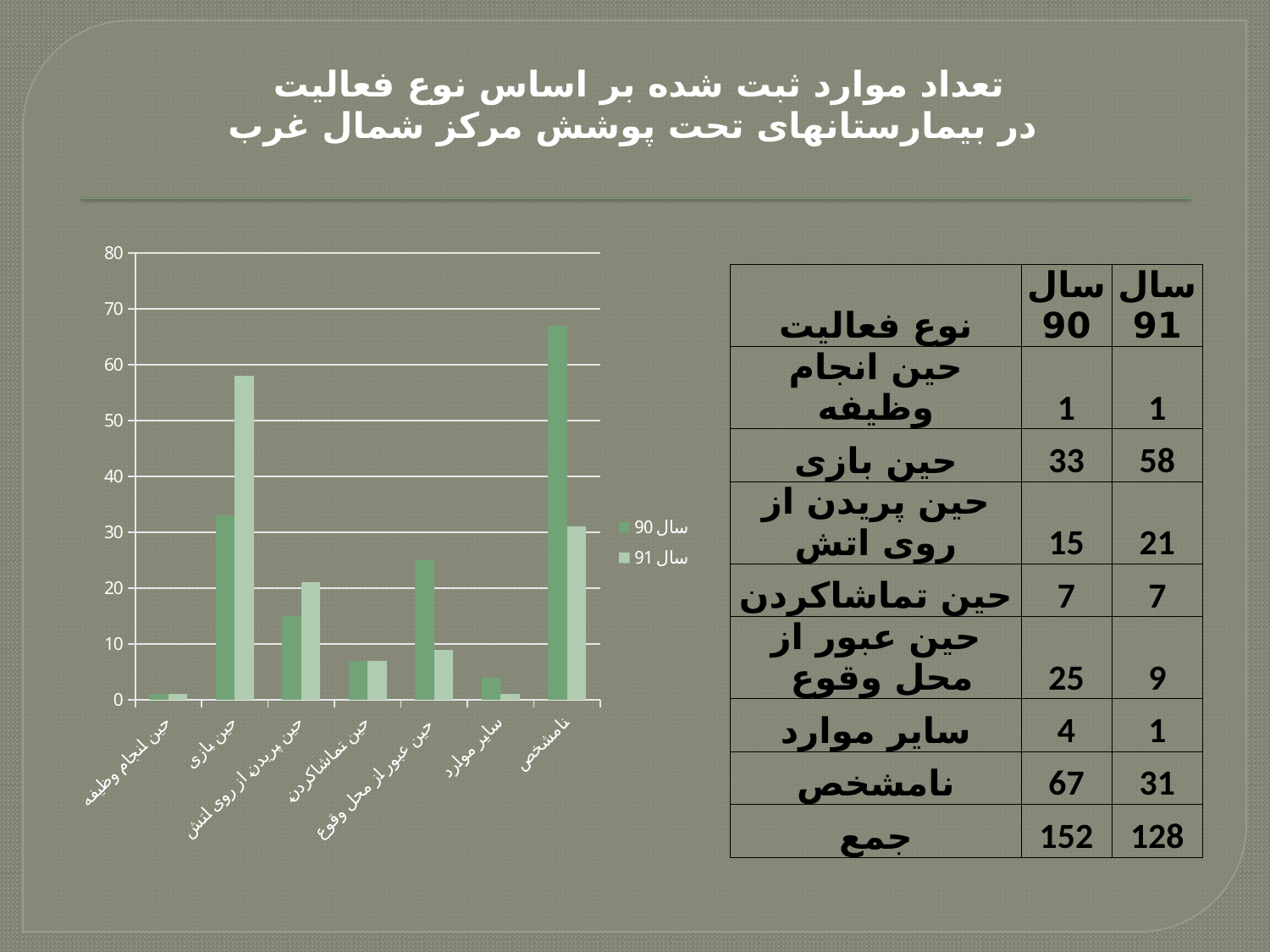
Is the value for نامشخص in the سال 90 series greater or less than 60? greater How many series does the chart legend list? 2 Which category has the highest value in the سال 91 series? حین بازی Which category has the lowest value in the سال 90 series? حین انجام وظیفه For حین عبور از محل وقوع, which series has the larger value, سال 90 or سال 91? سال 90 What is the value for نامشخص in the سال 90 series? 67 How many activity categories are plotted along the x axis of the chart? 7 What is the value for حین عبور از محل وقوع in the سال 91 series? 9 What is the value for حین بازی in the سال 91 series? 58 Which category has the highest value in the سال 90 series? نامشخص What kind of chart is shown on the slide? bar chart What is the difference between the سال 91 and سال 90 values for حین بازی? 25